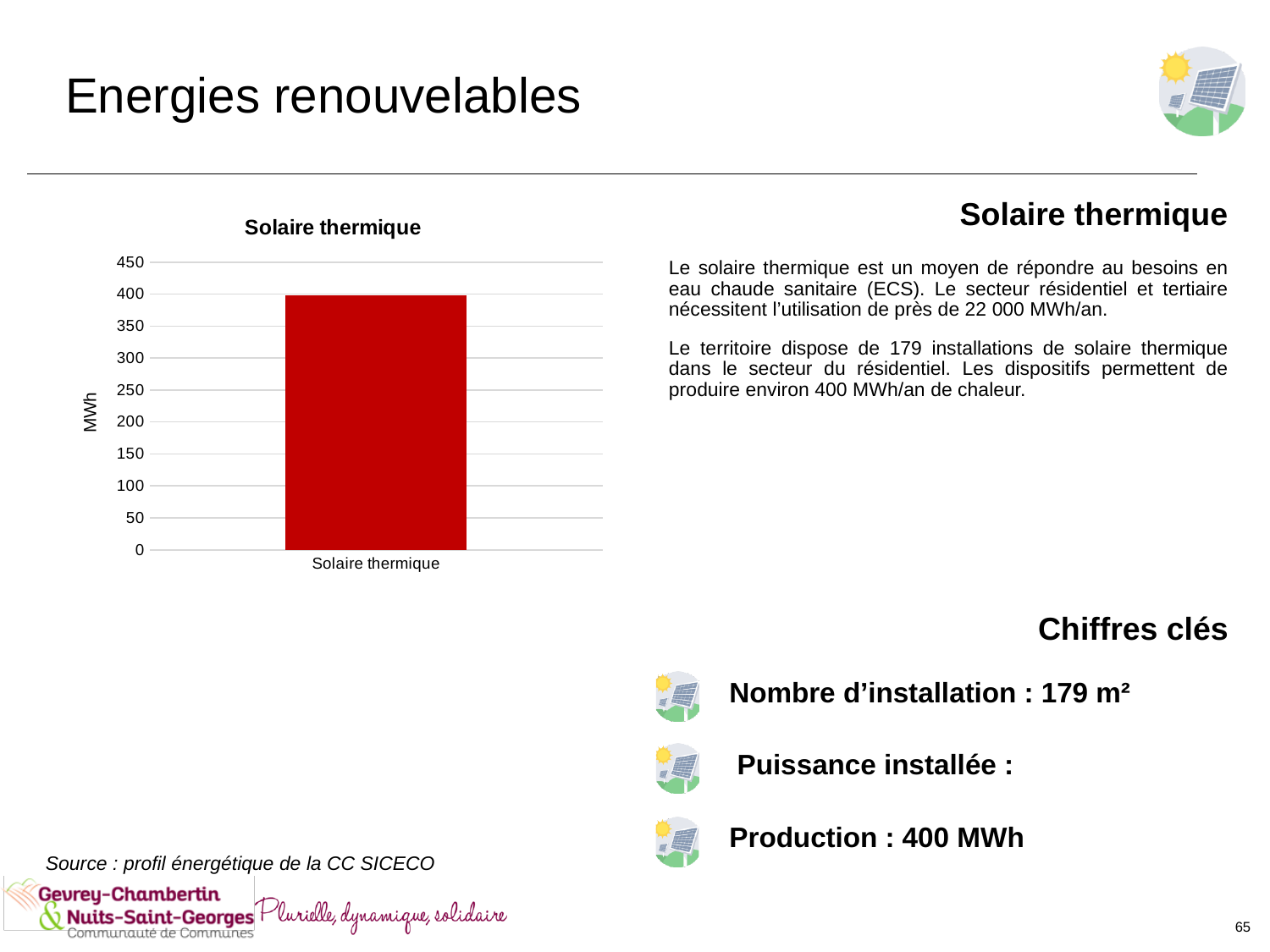
What is the label of the single category on the x axis of the chart? Solaire thermique Is the value for Solaire thermique greater or less than 200? greater How many bars does the chart show? 1 What is the highest value shown on the vertical axis of the chart? 450 What kind of chart is shown on the slide? bar chart What unit is shown on the vertical axis of the chart? MWh Is the value for Solaire thermique greater or less than 450? less What is the title of the chart? Solaire thermique Is the value for Solaire thermique greater or less than 350? greater